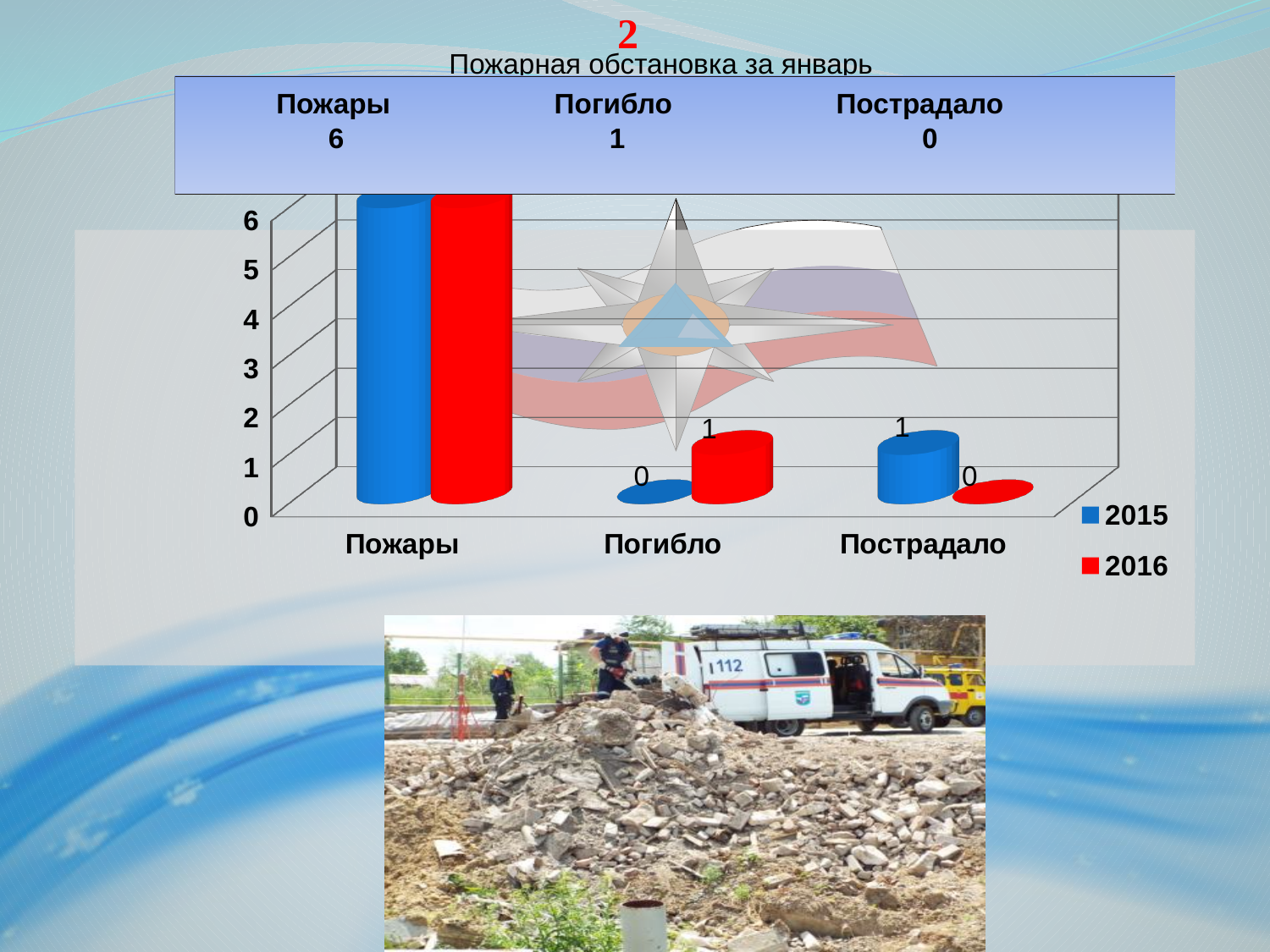
What is the value for Пострадало in the 2016 series? 0 What are the two entries listed in the chart legend? 2015 and 2016 What is the difference between the 2015 and 2016 values for Пострадало? 1 Is the value for Пожары in the 2015 series greater or less than 4? greater What is the value for Погибло in the 2016 series? 1 For Погибло, which series has the larger value, 2015 or 2016? 2016 What kind of chart is shown on the slide? bar chart Which category has the highest value in the 2016 series? Пожары How many categories are shown on the x axis of the chart? 3 What is the value for Погибло in the 2015 series? 0 How many series does the legend list? 2 What is the value for Пострадало in the 2015 series? 1